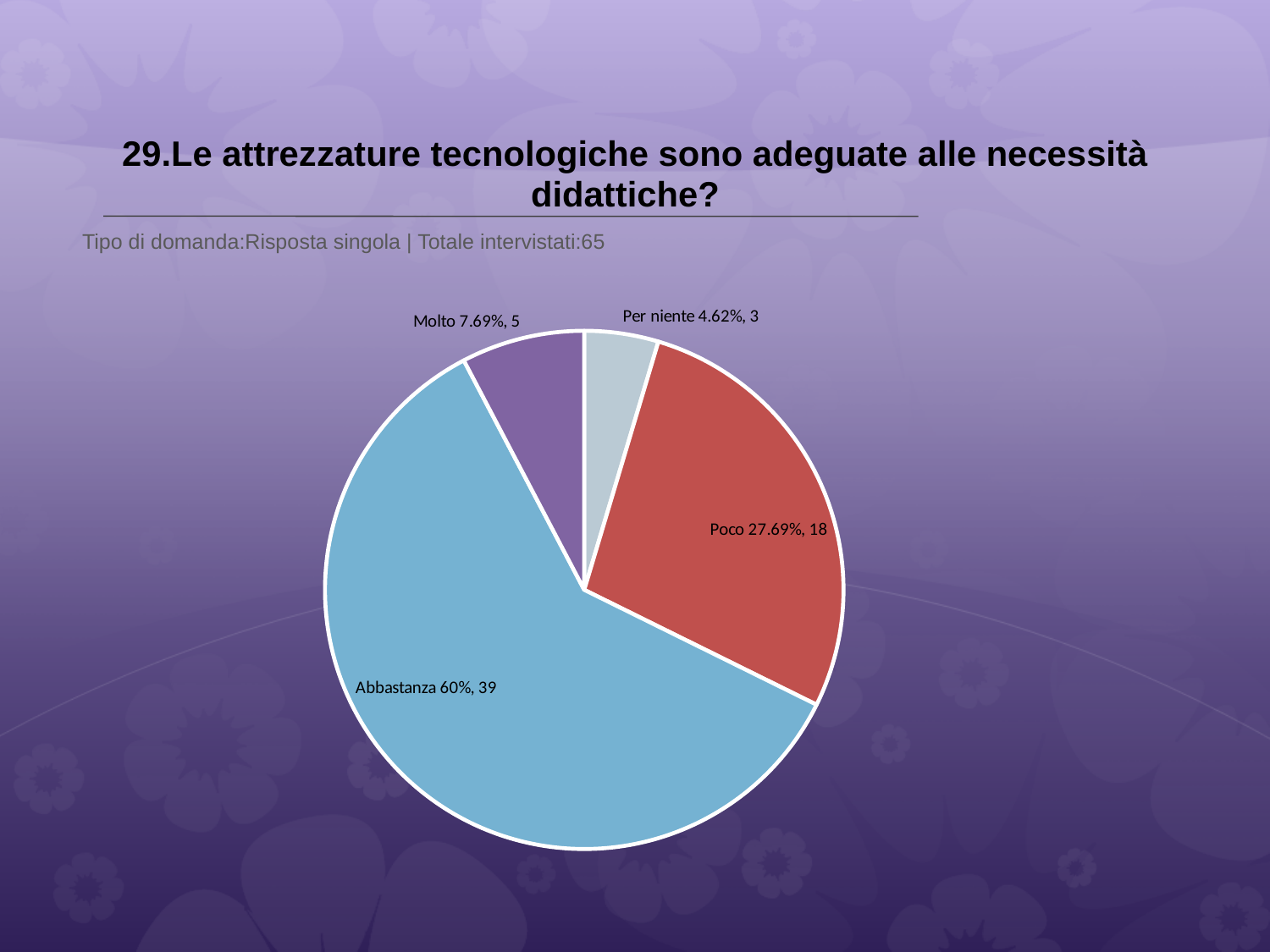
Which has a larger count, 'Molto' or 'Per niente'? Molto What is the count for the 'Molto' slice? 5 What is the count for the 'Abbastanza' slice? 39 What is the difference in count between 'Abbastanza' and 'Poco'? 21 What kind of chart is shown on the slide? pie chart Which category has the largest slice of the pie? Abbastanza How many slices does the pie chart have? 4 What is the total number of respondents stated on the slide? 65 Which category has the smallest slice of the pie? Per niente What percentage share does the 'Poco' slice have? 27.69% What percentage share does the 'Per niente' slice have? 4.62% What colour is the 'Poco' slice? red